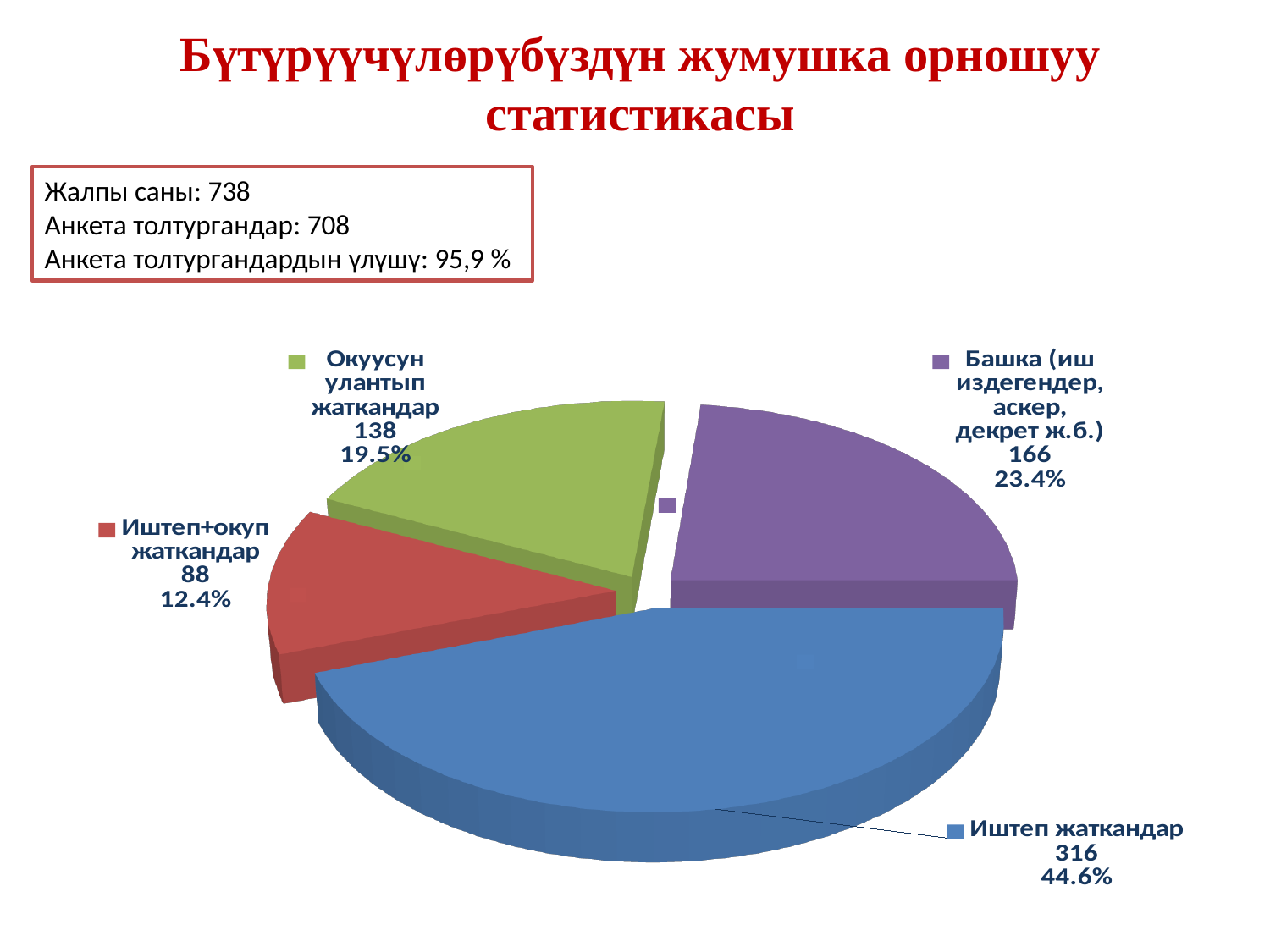
What share of the pie does Иштеп+окуп жаткандар represent? 12.4% What kind of chart is shown on the slide? Pie chart What share of the pie does Иштеп жаткандар represent? 44.6% Which category has the largest slice? Иштеп жаткандар What is the difference between the values for Иштеп жаткандар and Башка (иш издегендер, аскер, декрет ж.б.)? 150 What is the value for Иштеп жаткандар? 316 What is the value for Башка (иш издегендер, аскер, декрет ж.б.)? 166 What is the value for Иштеп+окуп жаткандар? 88 How many slices does the pie chart have? 4 Which category has the smallest slice? Иштеп+окуп жаткандар What is the value for Окуусун улантып жаткандар? 138 Which is larger, the value for Окуусун улантып жаткандар or the value for Иштеп+окуп жаткандар? Окуусун улантып жаткандар